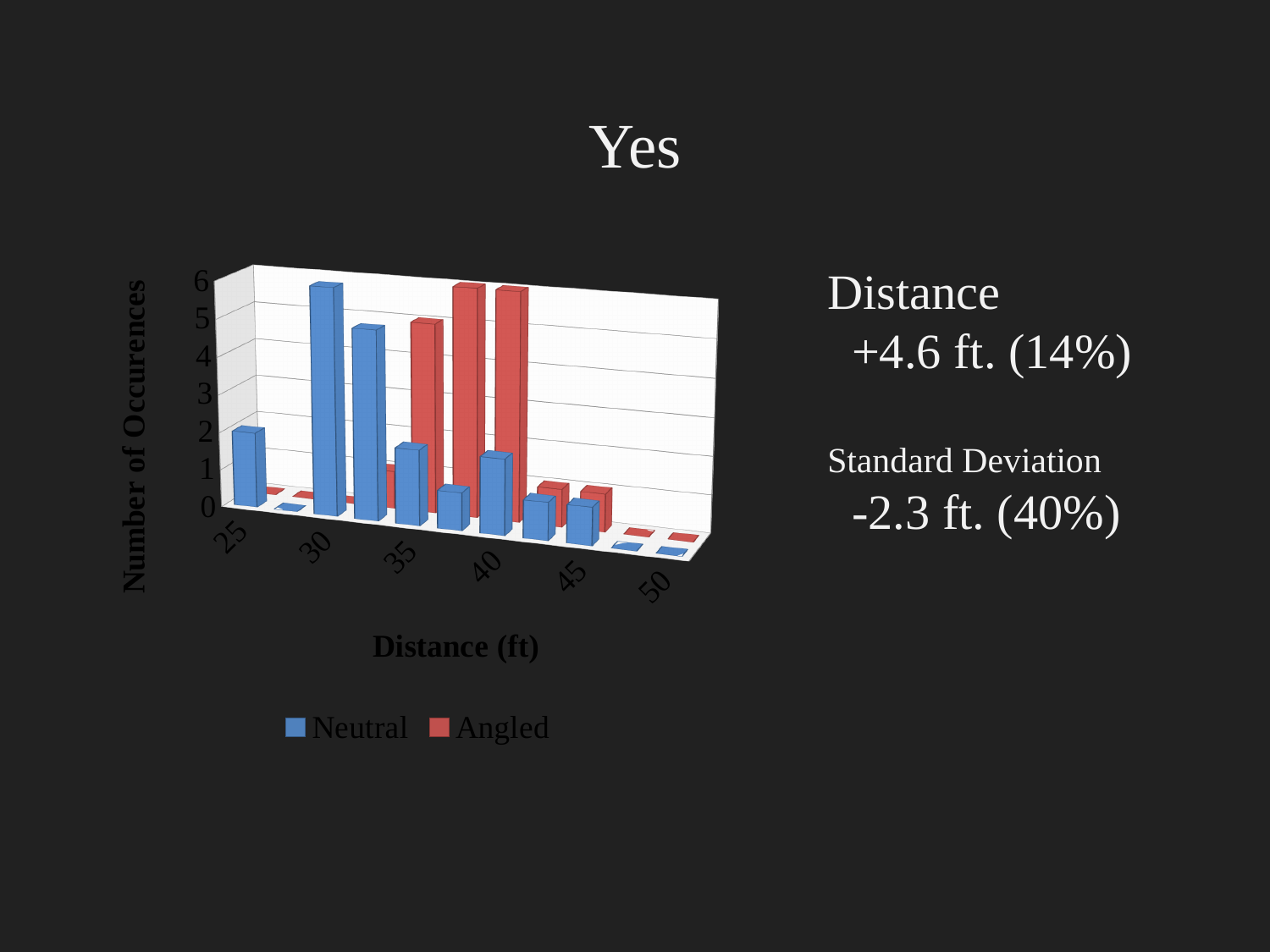
Is the Angled value at 35 ft greater or less than 3? greater Is the Angled value at 25 ft greater or less than 1? less At 30 ft, which series has the larger value, Neutral or Angled? Neutral Is the Neutral value at 30 ft greater or less than 4? greater What kind of chart is shown on the slide? bar chart What are the two series named in the chart's legend? Neutral and Angled What is the title of the chart's horizontal axis? Distance (ft) At 40 ft, which series has the larger value, Neutral or Angled? Angled How many series does the chart's legend list? 2 At 25 ft, which series has the larger value, Neutral or Angled? Neutral